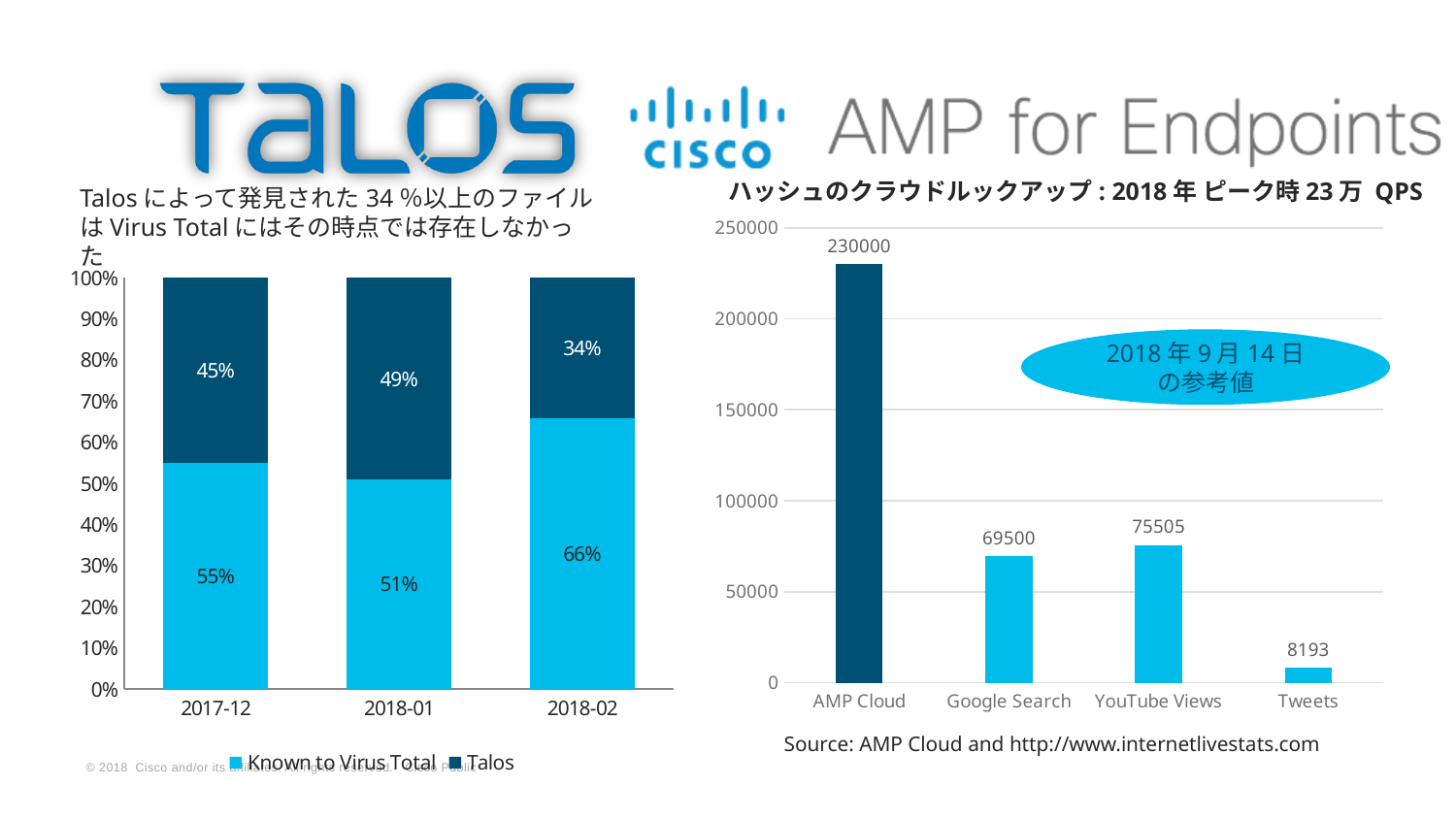
In the right chart, how many categories are shown on the x axis? 4 In the right chart, what is the value for Tweets? 8193 In the left stacked bar chart, what is the Talos value for 2018-02? 34% In the left stacked bar chart, what is the difference between the Talos values for 2018-01 and 2018-02? 15% In the left stacked bar chart, which period has the highest Known to Virus Total share? 2018-02 In the left stacked bar chart, what is the Known to Virus Total value for 2017-12? 55% In the right chart, which is larger, Google Search or YouTube Views? YouTube Views In the right chart, which category has the lowest value? Tweets In the right chart, what is the value for AMP Cloud? 230000 In the left stacked bar chart, what is the total of the 2018-01 bar? 100% In the right chart, what is the difference between YouTube Views and Google Search? 6005 In the left stacked bar chart, how many series does the legend list? 2